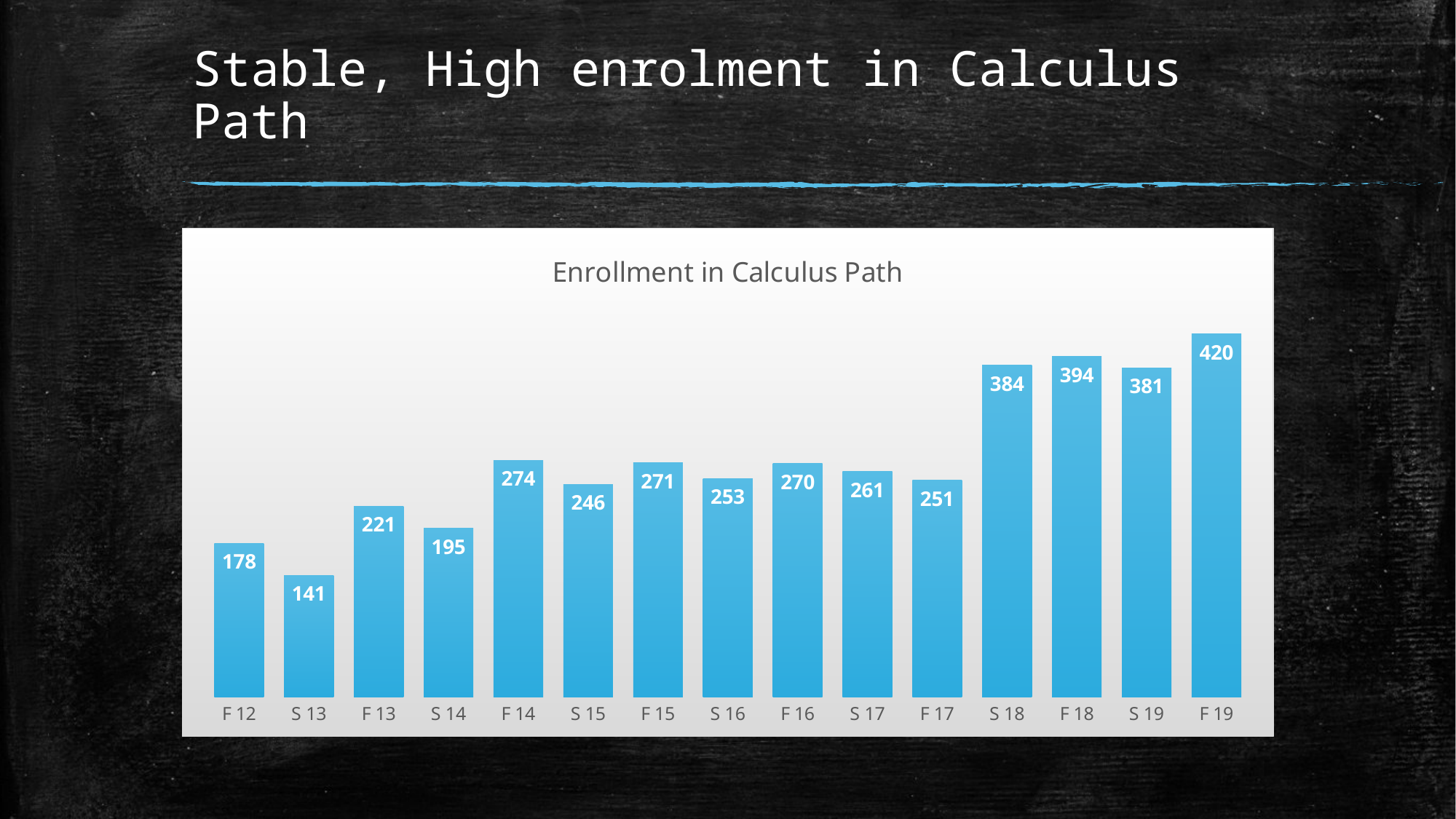
What is the enrollment value for S 13? 141 Which has a higher enrollment, S 17 or F 17? S 17 What is the enrollment value for S 18? 384 How many terms are shown on the x axis? 15 Which term has the lowest enrollment? S 13 Which has a higher enrollment, F 13 or S 14? F 13 What is the enrollment value for F 14? 274 What is the difference in enrollment between F 19 and F 12? 242 What kind of chart is shown on the slide? Bar chart Which term has the highest enrollment? F 19 What is the difference in enrollment between F 18 and S 19? 13 What is the title of the chart? Enrollment in Calculus Path